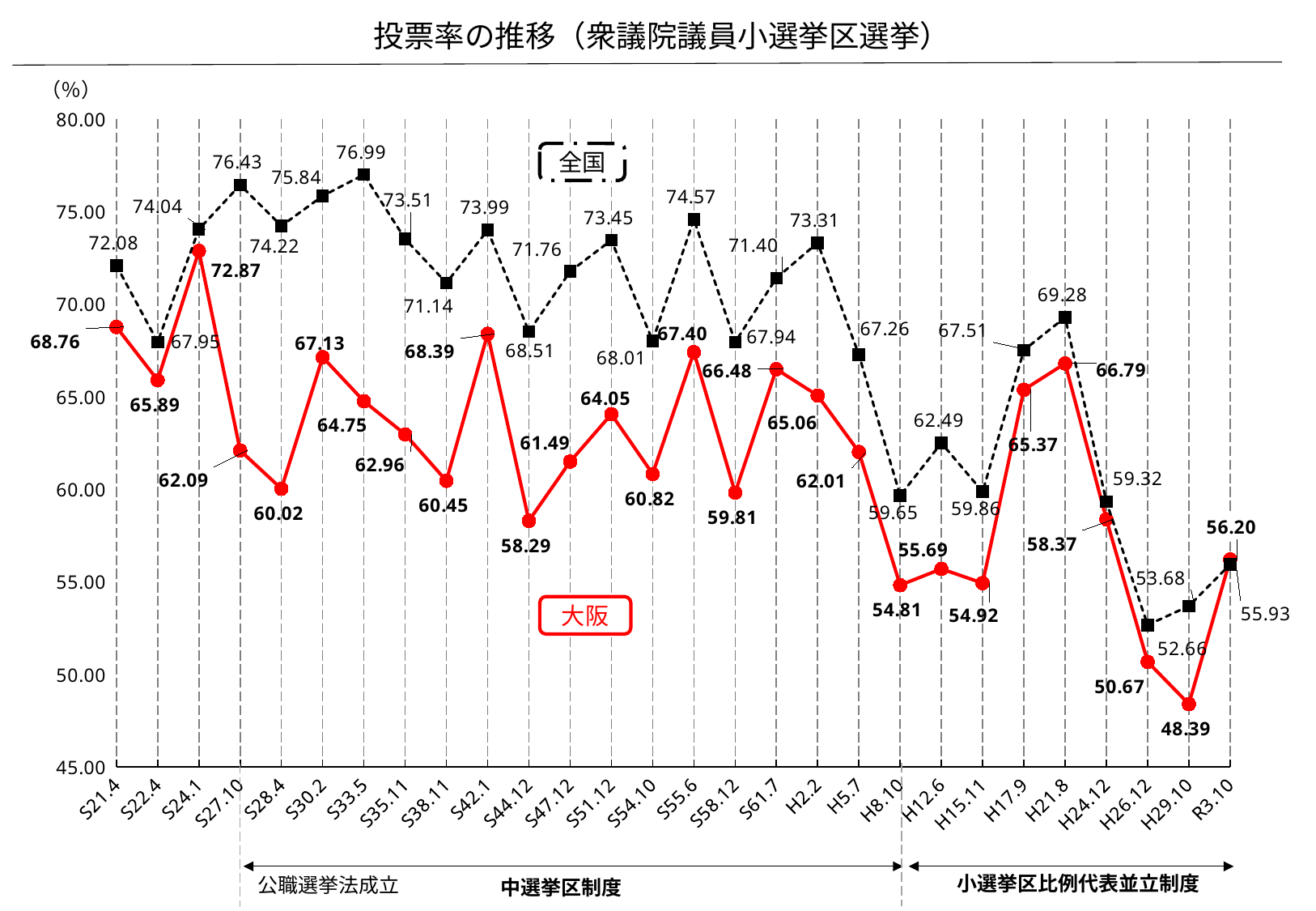
Is the 大阪 value for H26.12 greater or less than 55.00? less How many series does the chart show? 2 What is the 全国 turnout value for H8.10? 59.65 At which election date does the 全国 series reach its highest value? S33.5 How many election dates are plotted along the x axis? 28 Which series is drawn as a red solid line? 大阪 What type of chart is shown on the slide? line chart Which series has the higher value at R3.10, 全国 or 大阪? 大阪 What is the difference between the 全国 and 大阪 values at S21.4? 3.32 What is the 大阪 turnout value for S24.1? 72.87 What is the difference between the 全国 and 大阪 values at H29.10? 5.29 At which election date does the 大阪 series reach its lowest value? H29.10